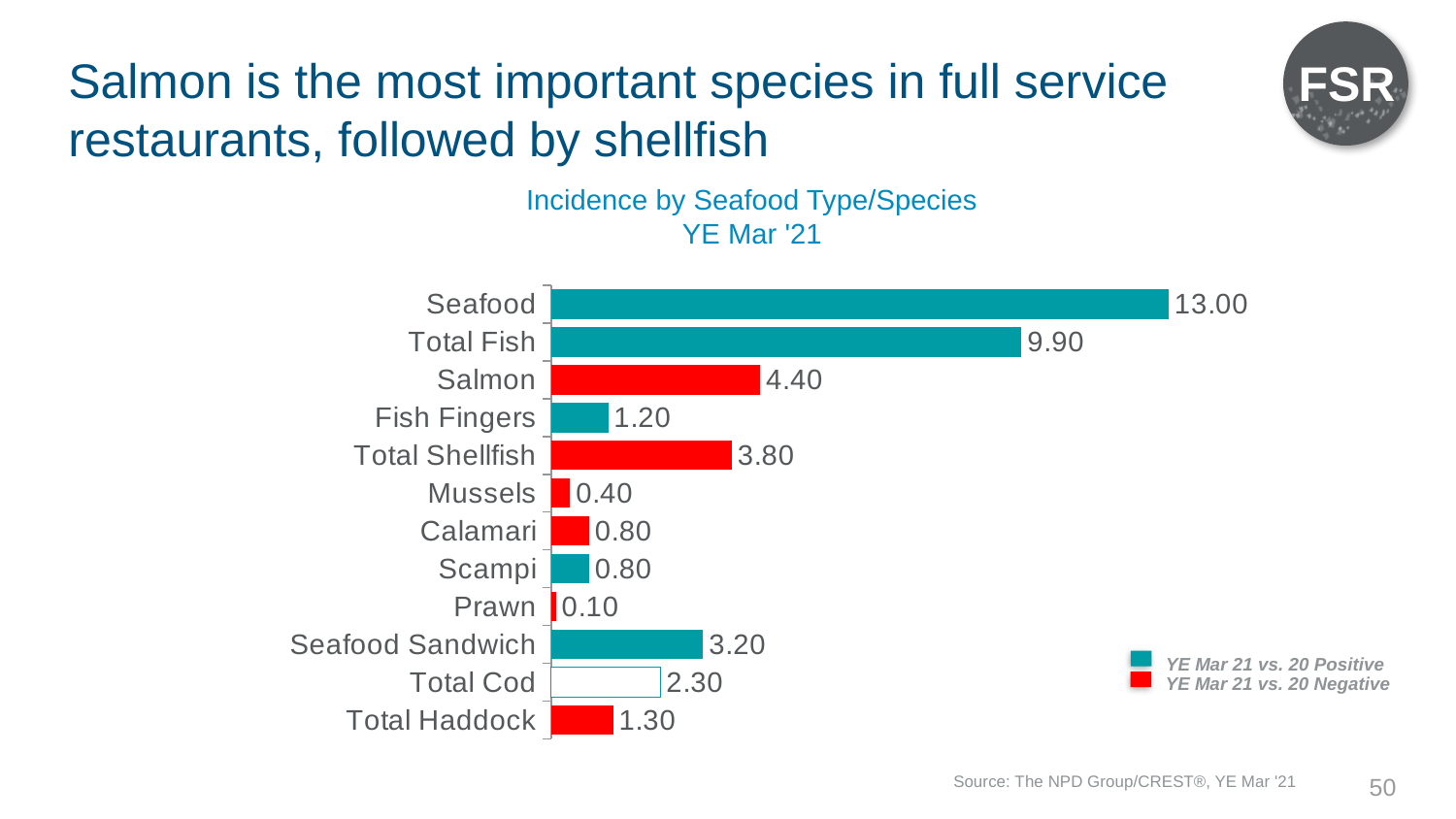
What is the title of the chart? Incidence by Seafood Type/Species YE Mar '21 What is the value for Total Shellfish? 3.80 What is the value for Seafood Sandwich? 3.20 Which is larger, the value for Fish Fingers or the value for Total Haddock? Total Haddock How many categories are shown in the chart? 12 Which category has the highest value? Seafood Which category has the lowest value? Prawn What kind of chart is shown on the slide? Bar chart What is the difference between the values for Total Cod and Total Haddock? 1.00 What is the difference between the values for Seafood and Total Fish? 3.10 What is the value for Salmon? 4.40 Which is larger, the value for Salmon or the value for Total Shellfish? Salmon